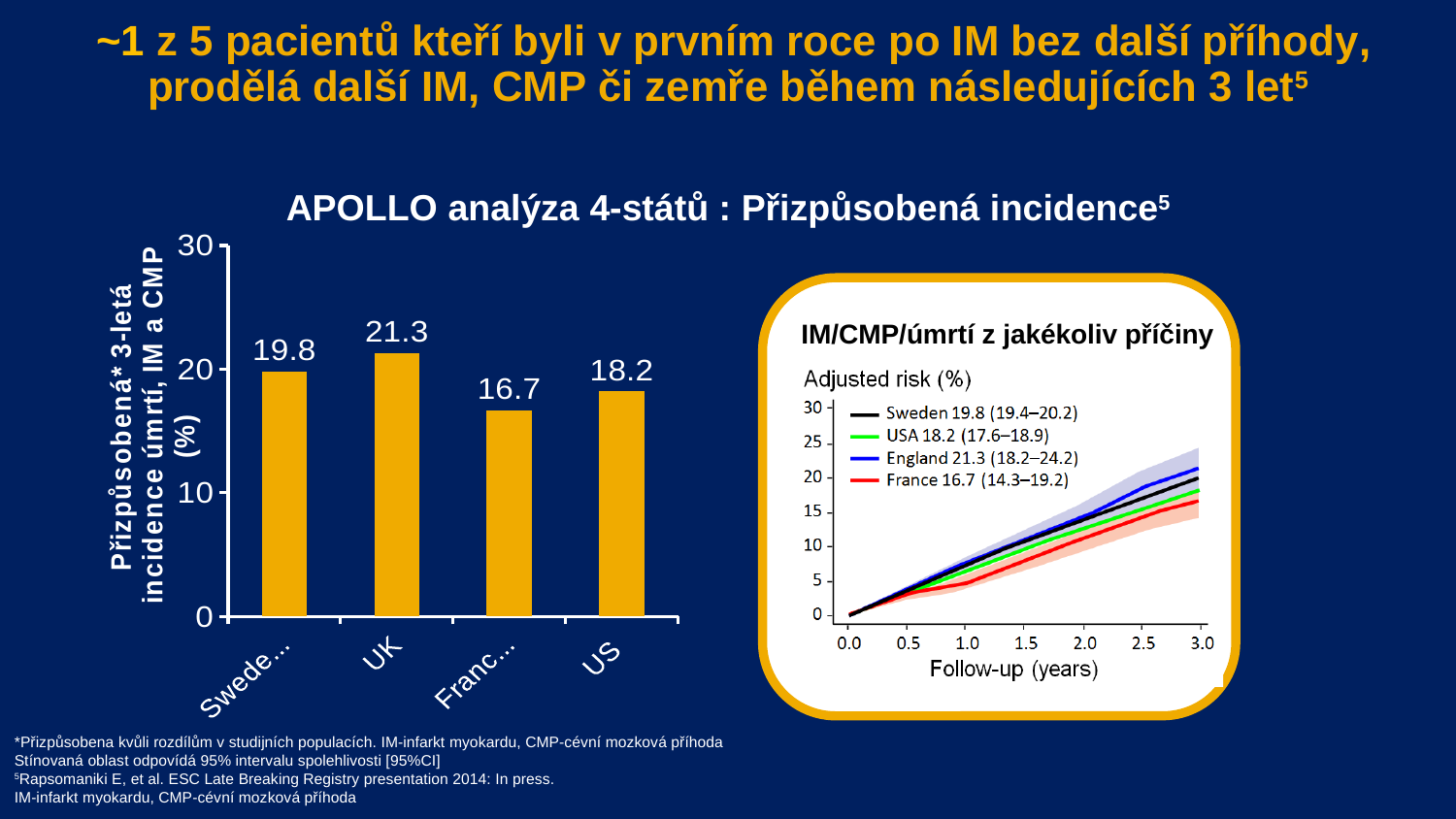
In the bar chart on the left, what is the adjusted 3-year incidence value shown for UK? 21.3 In the bar chart on the left, what is the difference between the Sweden value and the US value? 1.6 In the line chart on the right, what is the label of the x axis? Follow-up (years) In the bar chart on the left, what is the difference between the UK value and the France value? 4.6 In the bar chart on the left, which country has the highest bar? UK In the bar chart on the left, what value is shown for US? 18.2 What kind of chart is the chart on the left of the slide? Bar chart In the bar chart on the left, which is larger, the value for Sweden or the value for US? Sweden How many bars are plotted in the bar chart on the left? 4 In the line chart on the right (IM/CMP/úmrtí z jakékoliv příčiny), how many series does the legend list? 4 In the line chart on the right, what adjusted risk value does the legend give for England? 21.3 In the bar chart on the left, which country has the lowest bar? France